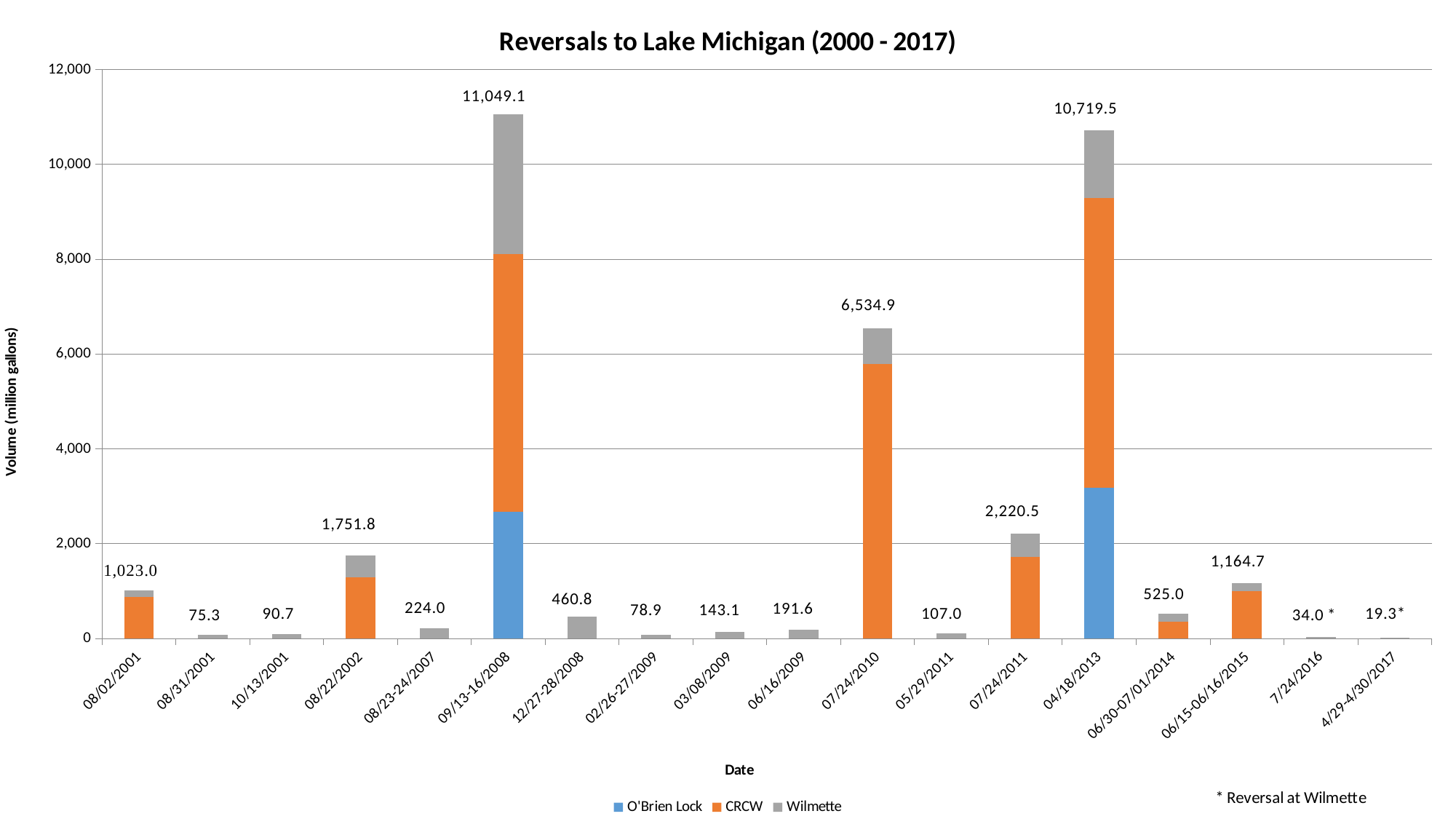
What is the difference between the total volumes for 08/22/2002 and 08/02/2001? 728.8 Which date has the lowest total reversal volume? 4/29-4/30/2017 What is the total volume labelled for the 07/24/2010 reversal? 6,534.9 How many dates (bars) are shown on the x axis? 18 What is the difference between the total volumes for 09/13-16/2008 and 04/18/2013? 329.6 Is the O'Brien Lock portion of the 04/18/2013 bar greater or less than 2,000? greater What is the total volume labelled for the 09/13-16/2008 reversal? 11,049.1 What is the total volume labelled for the 06/15-06/16/2015 reversal? 1,164.7 What type of chart is shown on the slide? Stacked bar chart Which has a larger total volume, 07/24/2011 or 06/30-07/01/2014? 07/24/2011 Which date has the highest total reversal volume? 09/13-16/2008 How many series does the legend list? 3